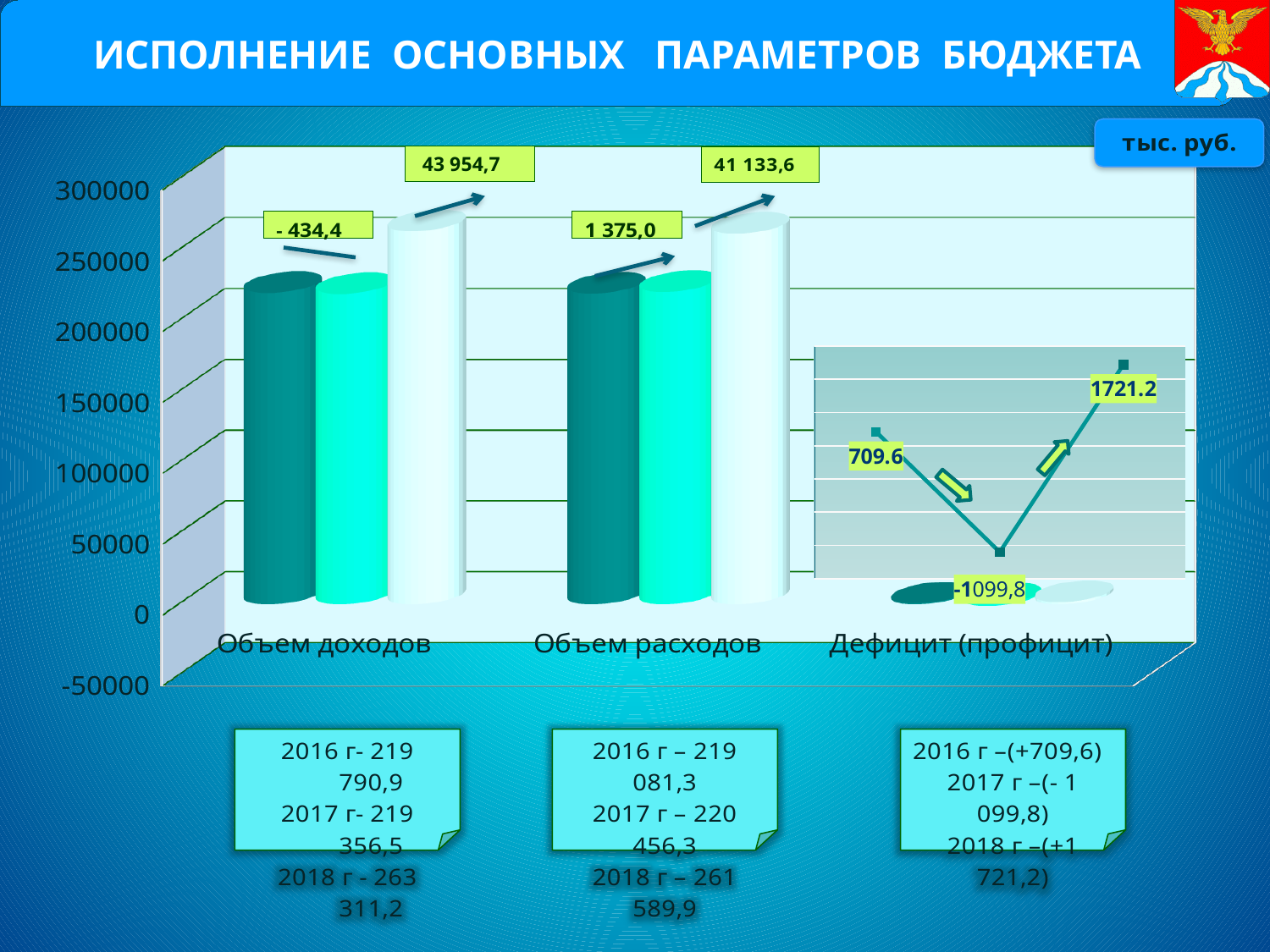
What is the value of Дефицит (профицит) for 2016 г? +709,6 Which year has the highest Объем доходов? 2018 г Which year has the lowest Дефицит (профицит) value? 2017 г Is the 2018 bar for Объем расходов greater or less than 250000? greater Which is larger: Объем доходов for 2016 г or Объем доходов for 2018 г? 2018 г How many categories are shown on the x axis of the main chart? 3 What is the title of the slide chart? ИСПОЛНЕНИЕ ОСНОВНЫХ ПАРАМЕТРОВ БЮДЖЕТА What is the value of Объем расходов for 2017 г? 220 456,3 In what units are the chart values given, according to the label in the top right? тыс. руб. By how much did Объем доходов change from 2017 г to 2018 г, according to the callout label? 43 954,7 What kind of chart is the main chart on the slide? bar chart What is the value of Объем доходов for 2018 г? 263 311,2